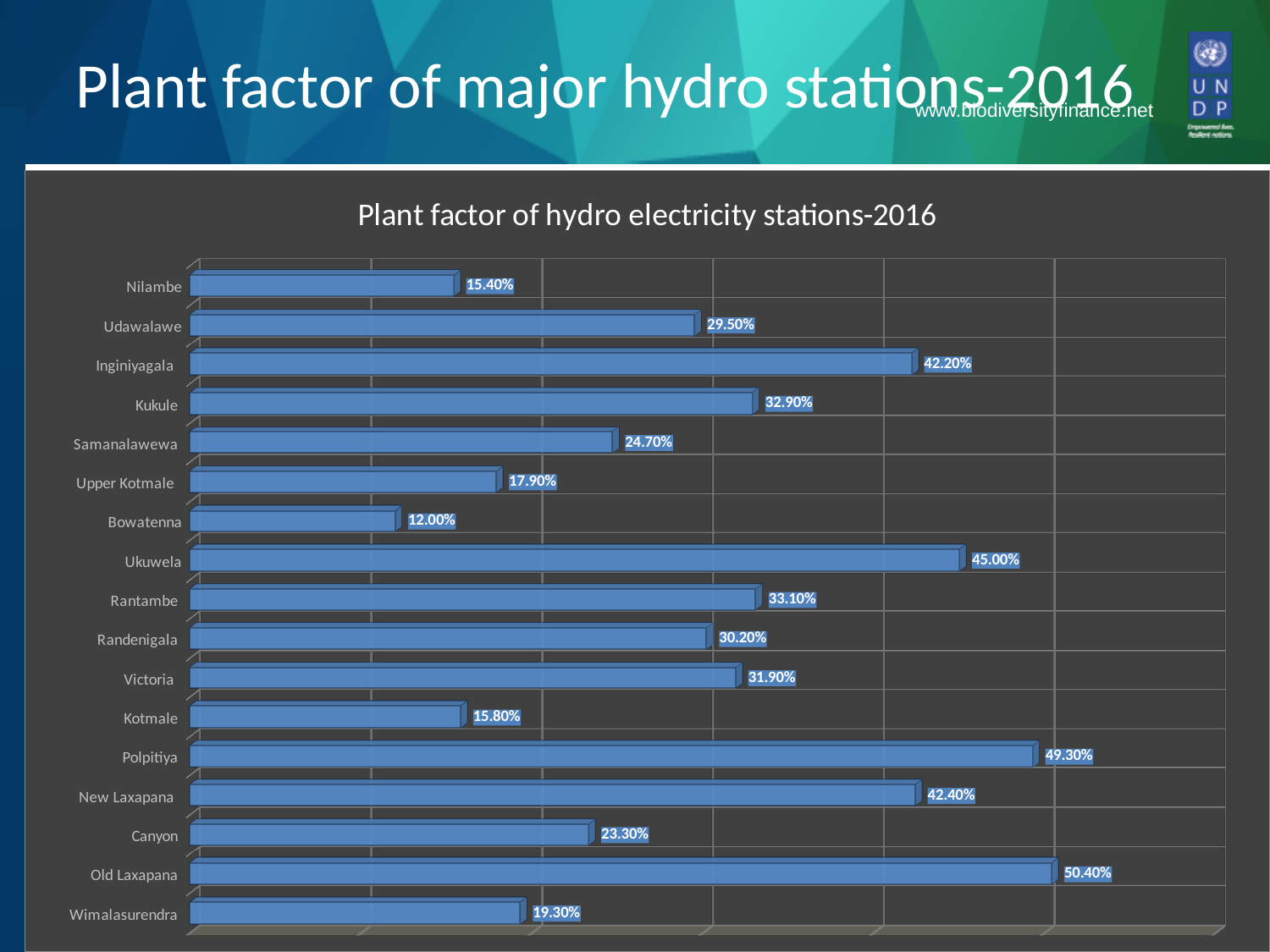
Which hydro station has the highest plant factor? Old Laxapana What is the plant factor for Ukuwela? 45.00% How many hydro stations are shown in the chart? 17 What type of chart is used on this slide? Bar chart What is the plant factor for New Laxapana? 42.40% What is the plant factor for Samanalawewa? 24.70% What is the title of the chart? Plant factor of hydro electricity stations-2016 What is the difference between the plant factors of Old Laxapana and Polpitiya? 1.10% Which hydro station has the lowest plant factor? Bowatenna Which has a higher plant factor, Victoria or Canyon? Victoria What is the difference between the plant factors of Ukuwela and Nilambe? 29.60% What is the plant factor for Wimalasurendra? 19.30%